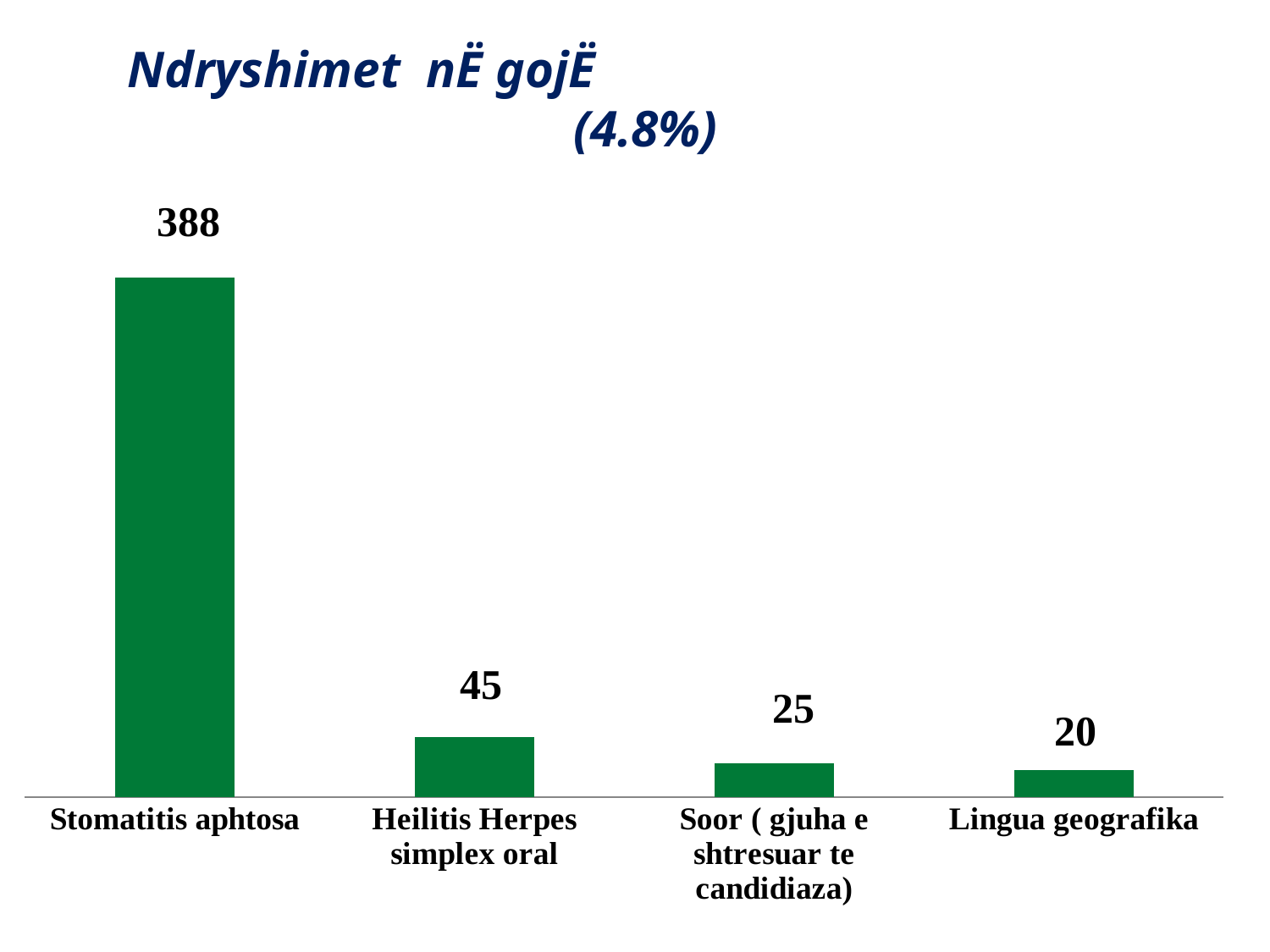
Which category has the lowest value? Lingua geografika What is the difference between the values for Soor (gjuha e shtresuar te candidiaza) and Lingua geografika? 5 Which category has the highest value? Stomatitis aphtosa What is the value for Lingua geografika? 20 How many categories are shown in the chart? 4 What is the value for Stomatitis aphtosa? 388 What is the value for Heilitis Herpes simplex oral? 45 What is the difference between the values for Stomatitis aphtosa and Heilitis Herpes simplex oral? 343 What is the value for Soor (gjuha e shtresuar te candidiaza)? 25 Which is larger, the value for Heilitis Herpes simplex oral or the value for Soor (gjuha e shtresuar te candidiaza)? Heilitis Herpes simplex oral What percentage is shown in the chart title? 4.8% What kind of chart is shown on the slide? bar chart